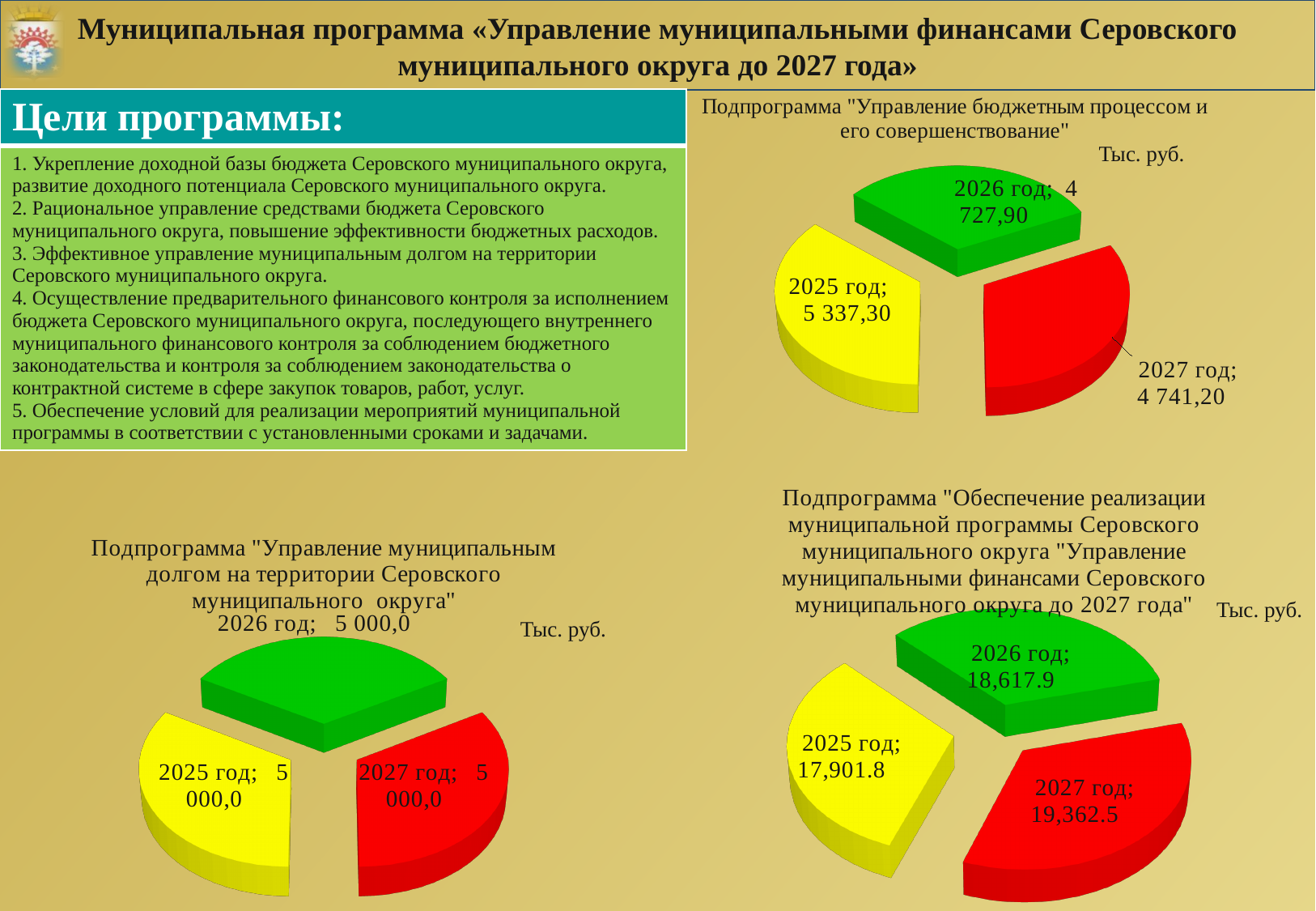
How many slices does the chart titled "Подпрограмма "Управление муниципальным долгом на территории Серовского муниципального округа"" have? 3 In the bottom-right chart ("Подпрограмма "Обеспечение реализации муниципальной программы...""), which year has the lowest value? 2025 год What kind of chart is the bottom-left chart on the slide? Pie chart What unit of measurement is shown next to the charts on the slide? Тыс. руб. In the chart titled "Подпрограмма "Управление бюджетным процессом и его совершенствование"", which year has the highest value? 2025 год In the chart titled "Подпрограмма "Управление бюджетным процессом и его совершенствование"", what is the difference between the values for 2025 год and 2027 год? 596,10 In the bottom-right chart ("Подпрограмма "Обеспечение реализации муниципальной программы...""), what is the difference between the values for 2027 год and 2025 год? 1,460.7 In the bottom-right chart ("Подпрограмма "Обеспечение реализации муниципальной программы...""), what is the value for 2025 год? 17,901.8 In the bottom-right chart ("Подпрограмма "Обеспечение реализации муниципальной программы...""), what is the value for 2027 год? 19,362.5 In the chart titled "Подпрограмма "Управление бюджетным процессом и его совершенствование"", what is the value for 2025 год? 5 337,30 In the chart titled "Подпрограмма "Управление муниципальным долгом на территории Серовского муниципального округа"", what is the value for 2026 год? 5 000,0 In the chart titled "Подпрограмма "Управление бюджетным процессом и его совершенствование"", what is the value for 2027 год? 4 741,20